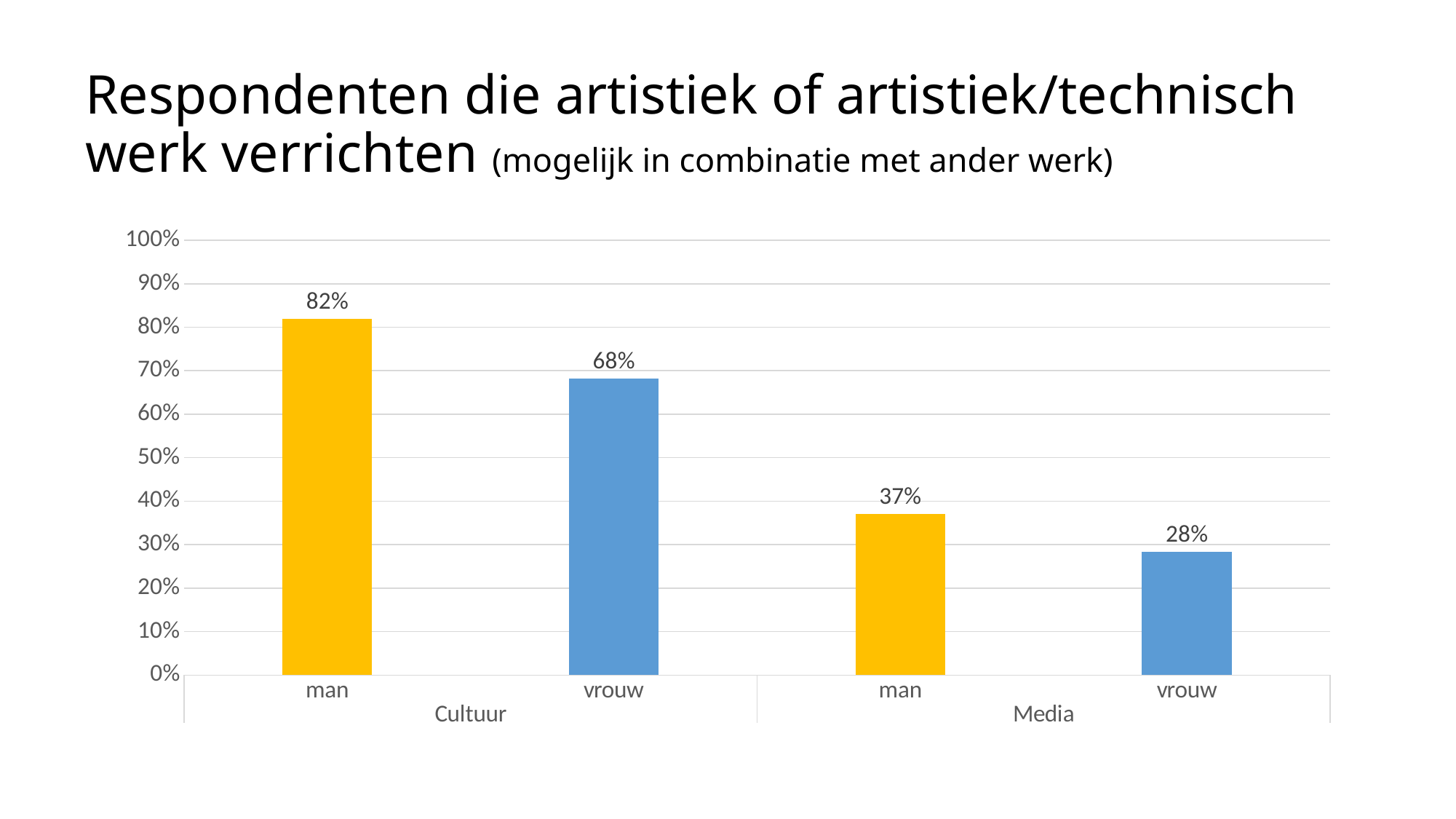
What are the two group labels shown on the x axis? Cultuur and Media What kind of chart is shown on the slide? bar chart What is the value for man in the Media group? 37% What is the difference between the man values for Cultuur and Media? 45% What is the value for man in the Cultuur group? 82% What is the value for vrouw in the Cultuur group? 68% How many bars are plotted in the chart? 4 Which bar has the lowest value? vrouw (Media) What is the difference between the man and vrouw values in the Cultuur group? 14% What is the value for vrouw in the Media group? 28% Which is larger: vrouw in Cultuur or man in Media? vrouw in Cultuur Which bar has the highest value? man (Cultuur)